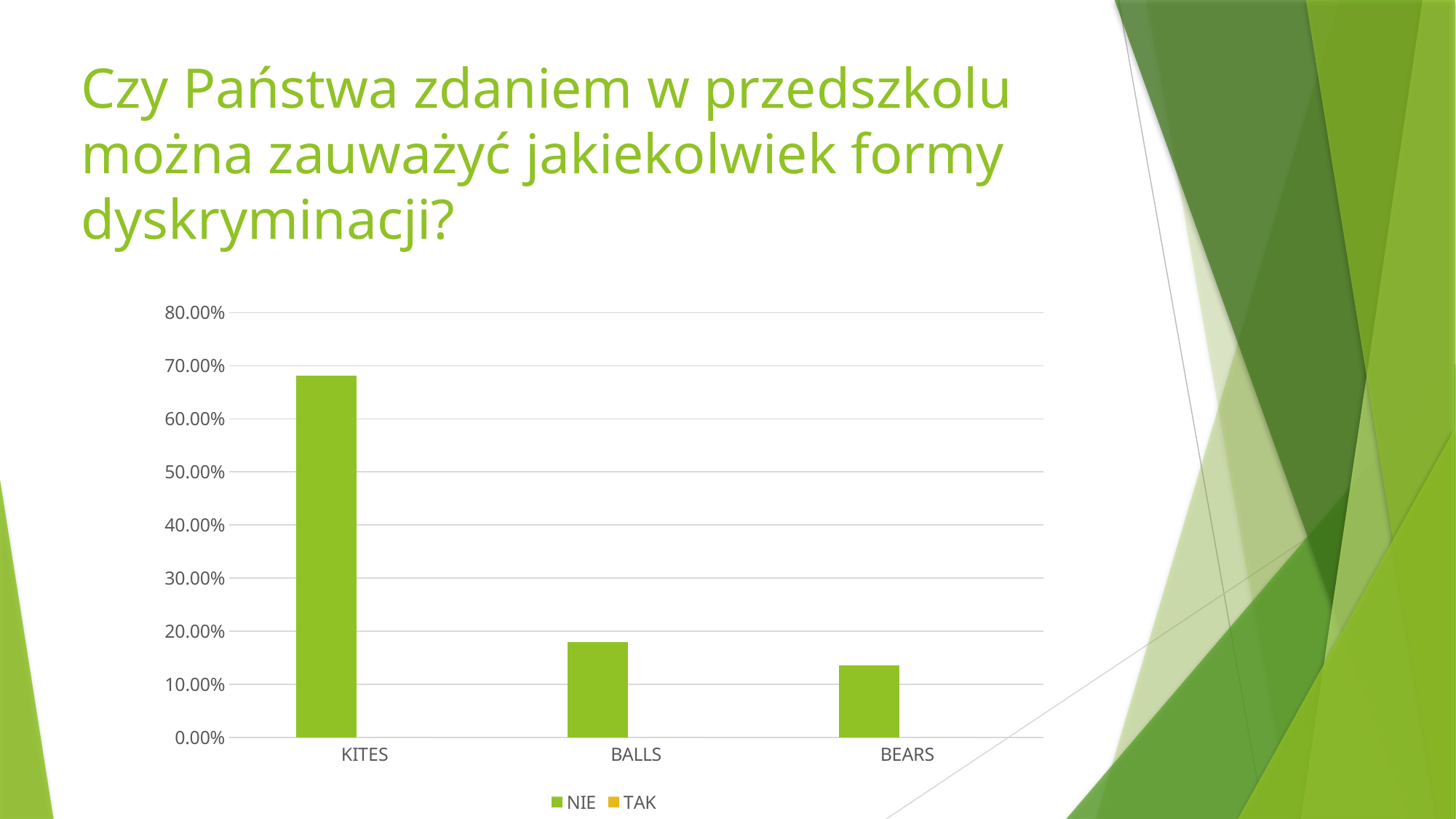
Do the NIE values rise or fall moving from KITES to BEARS along the x axis? fall Which category has the lowest NIE value? BEARS Is the NIE value for BEARS greater or less than 10.00%? greater Which category has the highest NIE value? KITES Is the NIE value for BALLS greater or less than 20.00%? less Which has a larger NIE value, BALLS or BEARS? BALLS Which has a larger NIE value, KITES or BALLS? KITES Which series is shown in green in the chart legend? NIE How many series does the chart legend list? 2 How many categories are shown on the x axis of the chart? 3 Is the NIE value for KITES greater or less than 60.00%? greater What kind of chart is shown on the slide? bar chart